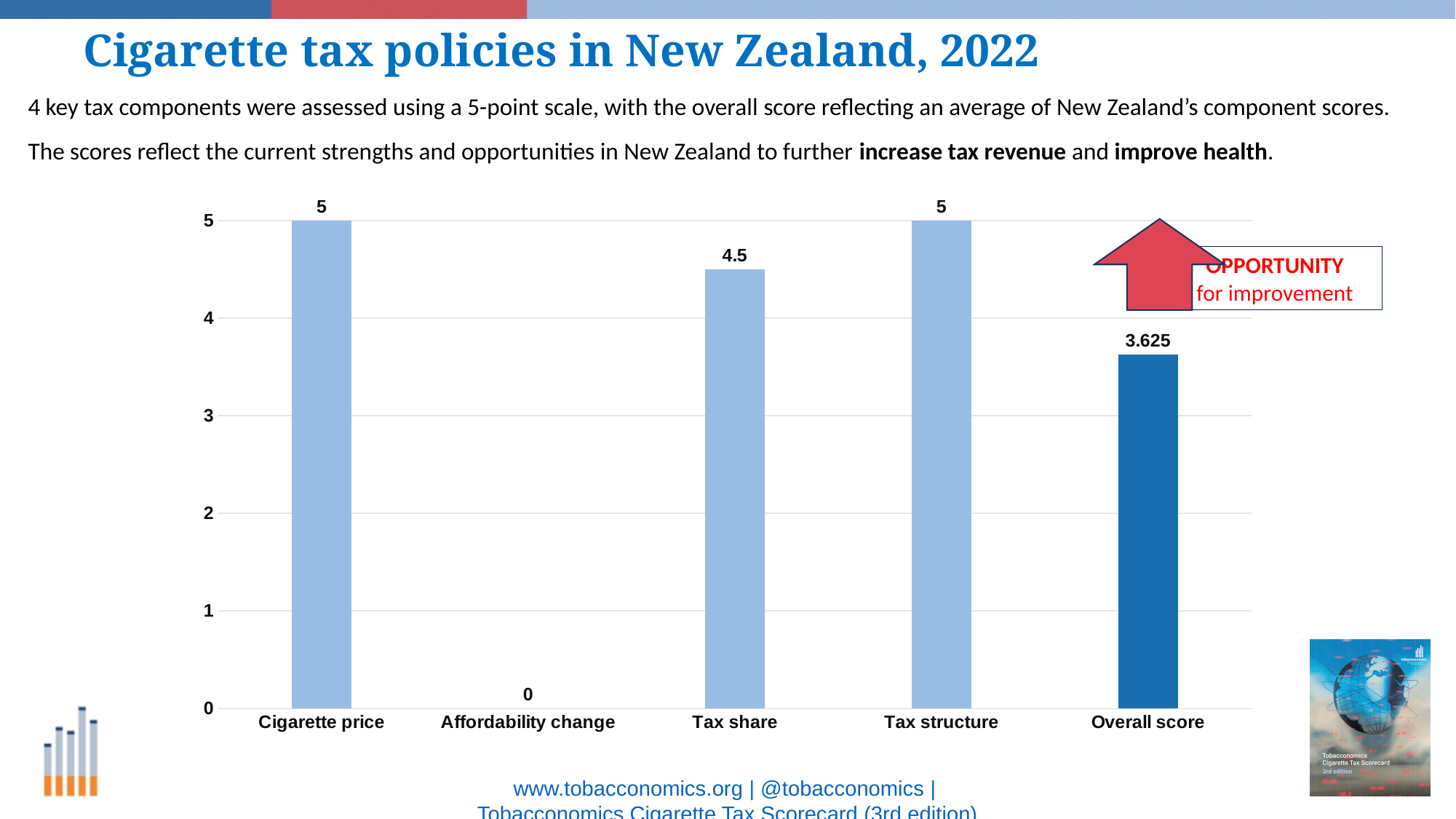
What is the value for Cigarette price? 5 What is the value for Affordability change? 0 How many categories are shown on the x axis? 5 Which bar is drawn in a darker blue than the others? Overall score Which category has the lowest value? Affordability change What is the value for Overall score? 3.625 What is the value for Tax share? 4.5 What is the difference between the values for Tax structure and Tax share? 0.5 What is the difference between the values for Cigarette price and Overall score? 1.375 What kind of chart is shown on the slide? bar chart Is the value for Overall score greater or less than 4? less Which is larger, the value for Tax share or the value for Overall score? Tax share